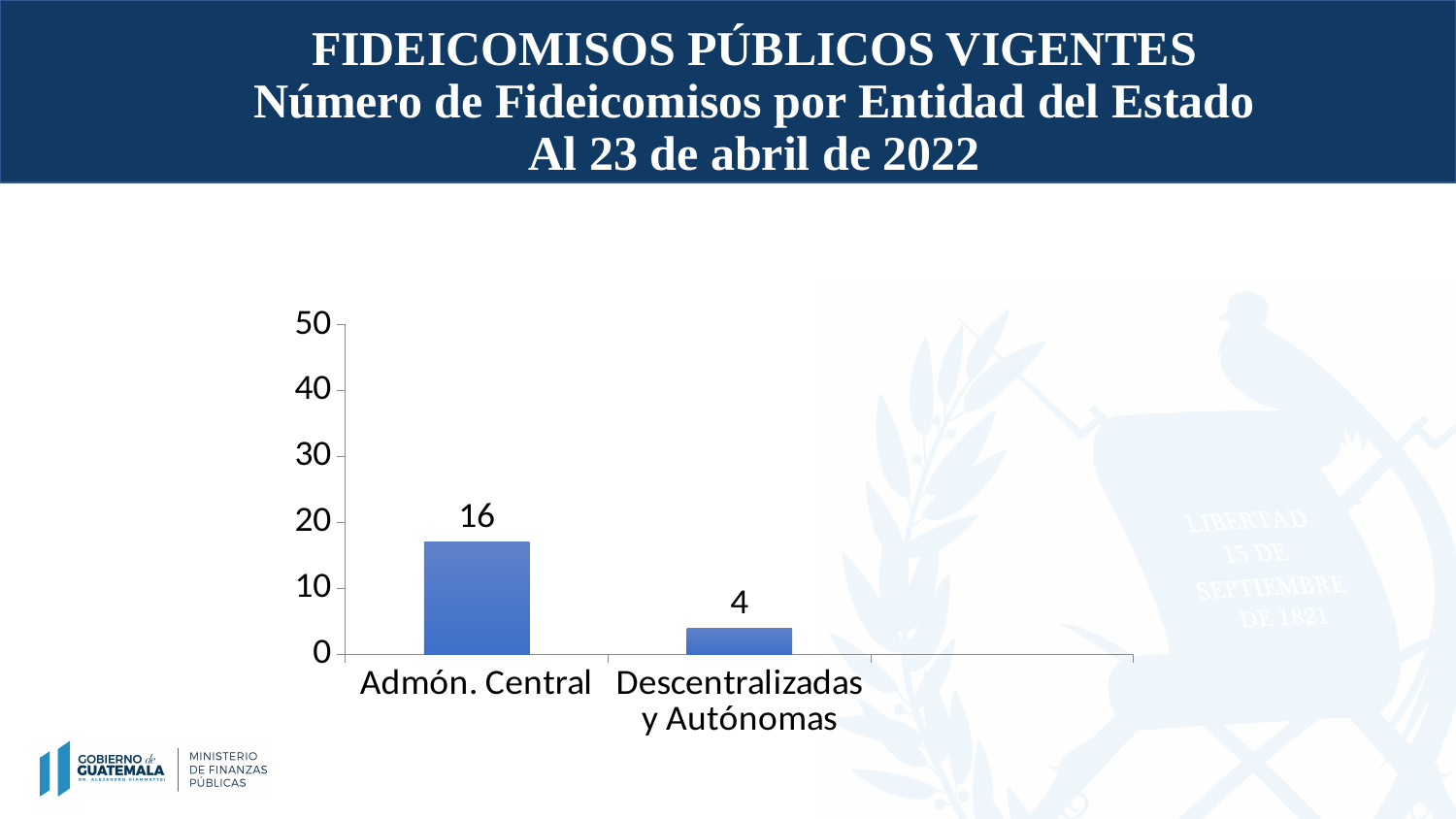
Is the value for Admón. Central greater or less than 10? greater What is the difference between the values for Admón. Central and Descentralizadas y Autónomas? 12 Which entity has the highest number of fideicomisos? Admón. Central What is the number of fideicomisos for Admón. Central? 16 Is the value for Descentralizadas y Autónomas greater or less than 10? less What is the total number of fideicomisos across both categories? 20 How many categories are shown on the chart? 2 What kind of chart is shown on the slide? Bar chart What is the number of fideicomisos for Descentralizadas y Autónomas? 4 Which entity has the lowest number of fideicomisos? Descentralizadas y Autónomas Which is larger, the value for Admón. Central or for Descentralizadas y Autónomas? Admón. Central What is the highest value shown on the vertical axis? 50